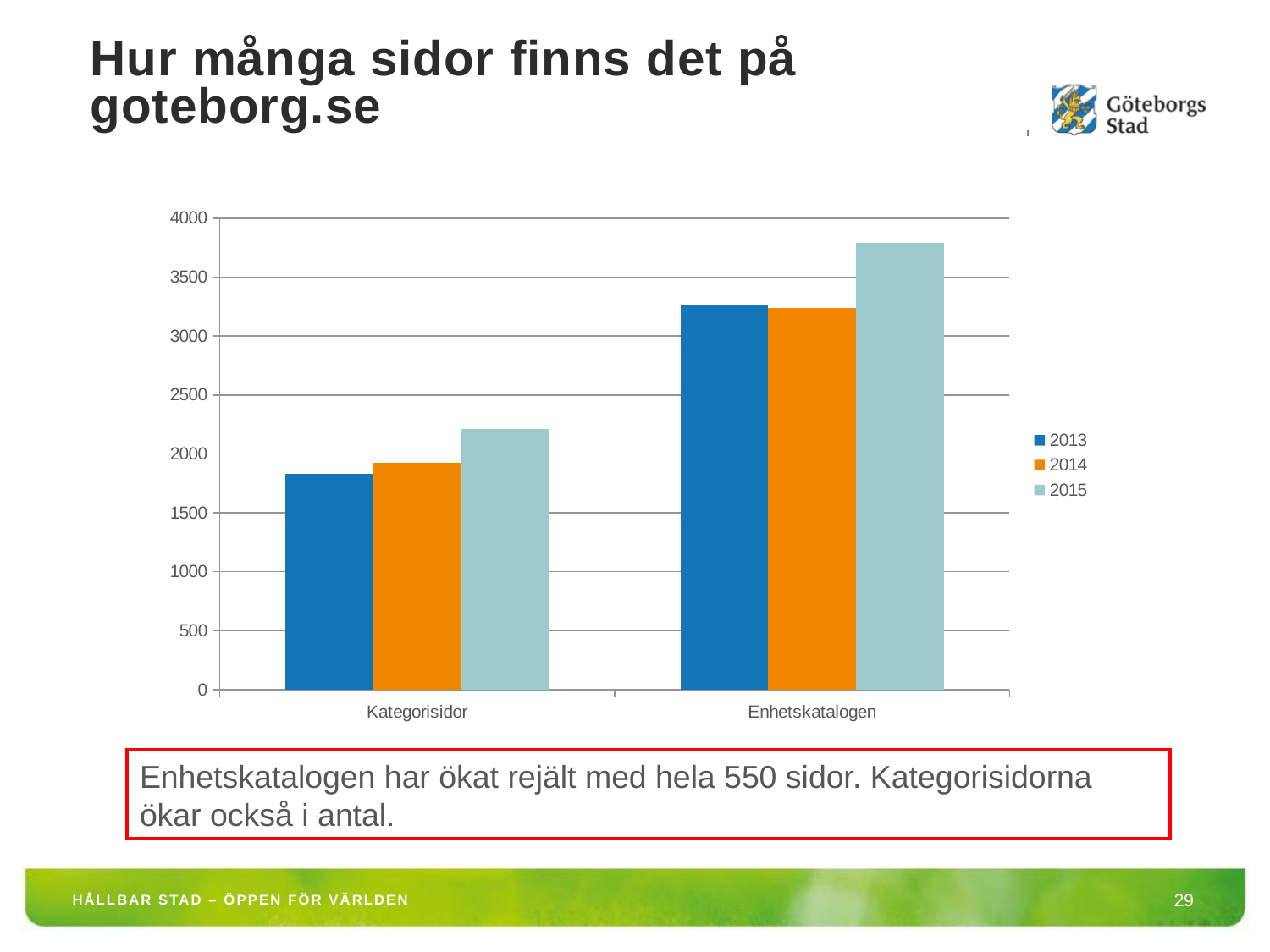
For Enhetskatalogen, which year has the highest value? 2015 Do the values for Kategorisidor rise or fall from 2013 to 2015? rise Is the value for Kategorisidor in 2015 greater or less than 2000? greater Which category has the higher values overall, Kategorisidor or Enhetskatalogen? Enhetskatalogen Is the value for Enhetskatalogen in 2015 greater or less than 3500? greater Is the value for Kategorisidor in 2013 greater or less than 2000? less How many categories are shown on the x axis? 2 Which years are listed in the legend? 2013, 2014, 2015 How many series does the legend list? 3 For Kategorisidor, which year has the lowest value? 2013 What kind of chart is shown on the slide? bar chart